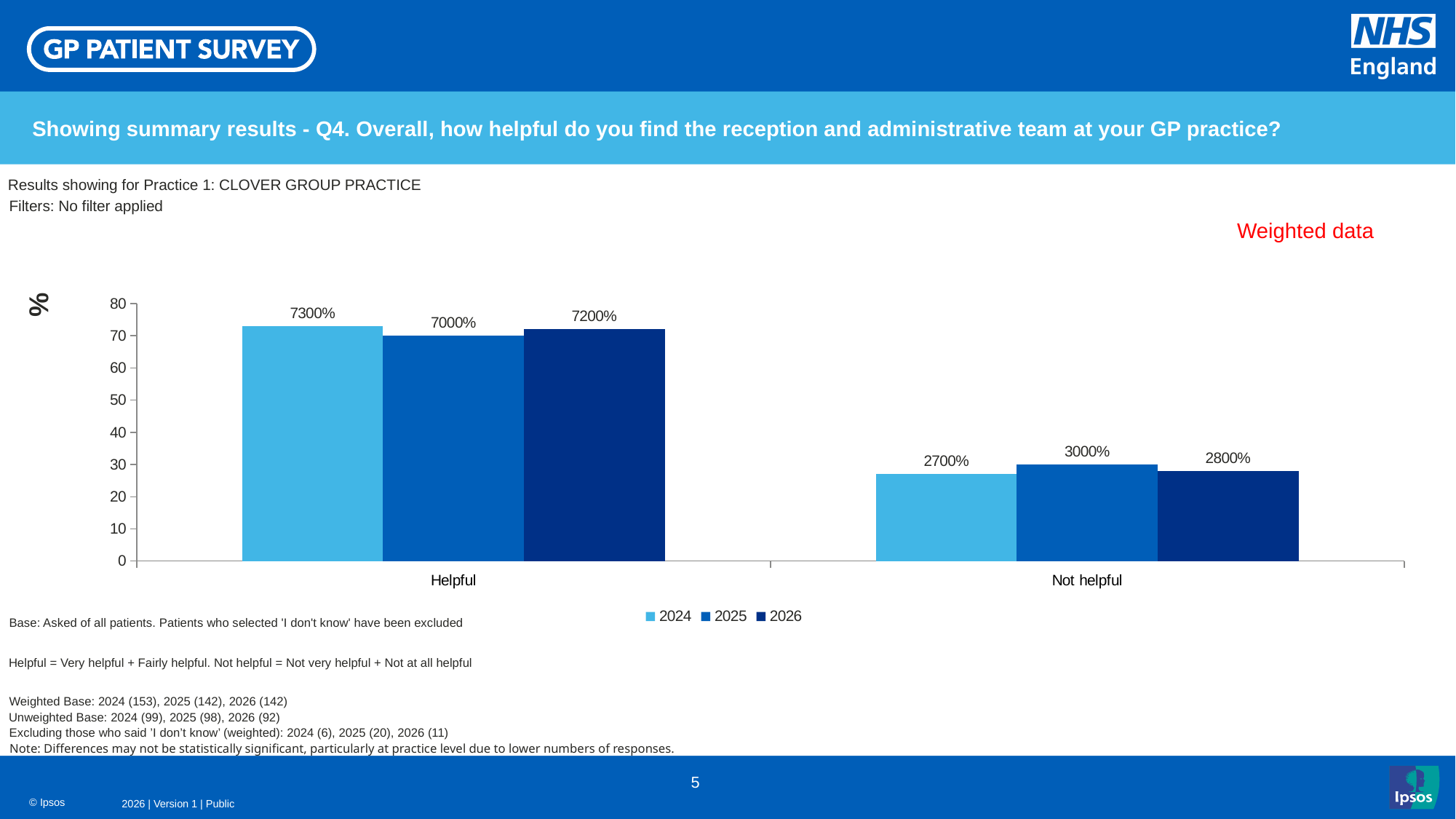
Which is larger in the Not helpful category: the 2025 bar or the 2026 bar? 2025 How many categories are shown on the x axis? 2 Is the 2025 bar for Helpful greater or less than 60 on the axis? greater Which year has the highest bar in the Helpful category? 2024 Which year has the lowest bar in the Not helpful category? 2024 Which practice are the results shown for? Practice 1: CLOVER GROUP PRACTICE What is the data label for 2024 in the Not helpful category? 2700% How many series does the legend list? 3 What kind of chart is shown on the slide? Bar chart What is the data label for 2024 in the Helpful category? 7300% What is the data label for 2026 in the Helpful category? 7200% What is the data label for 2025 in the Not helpful category? 3000%